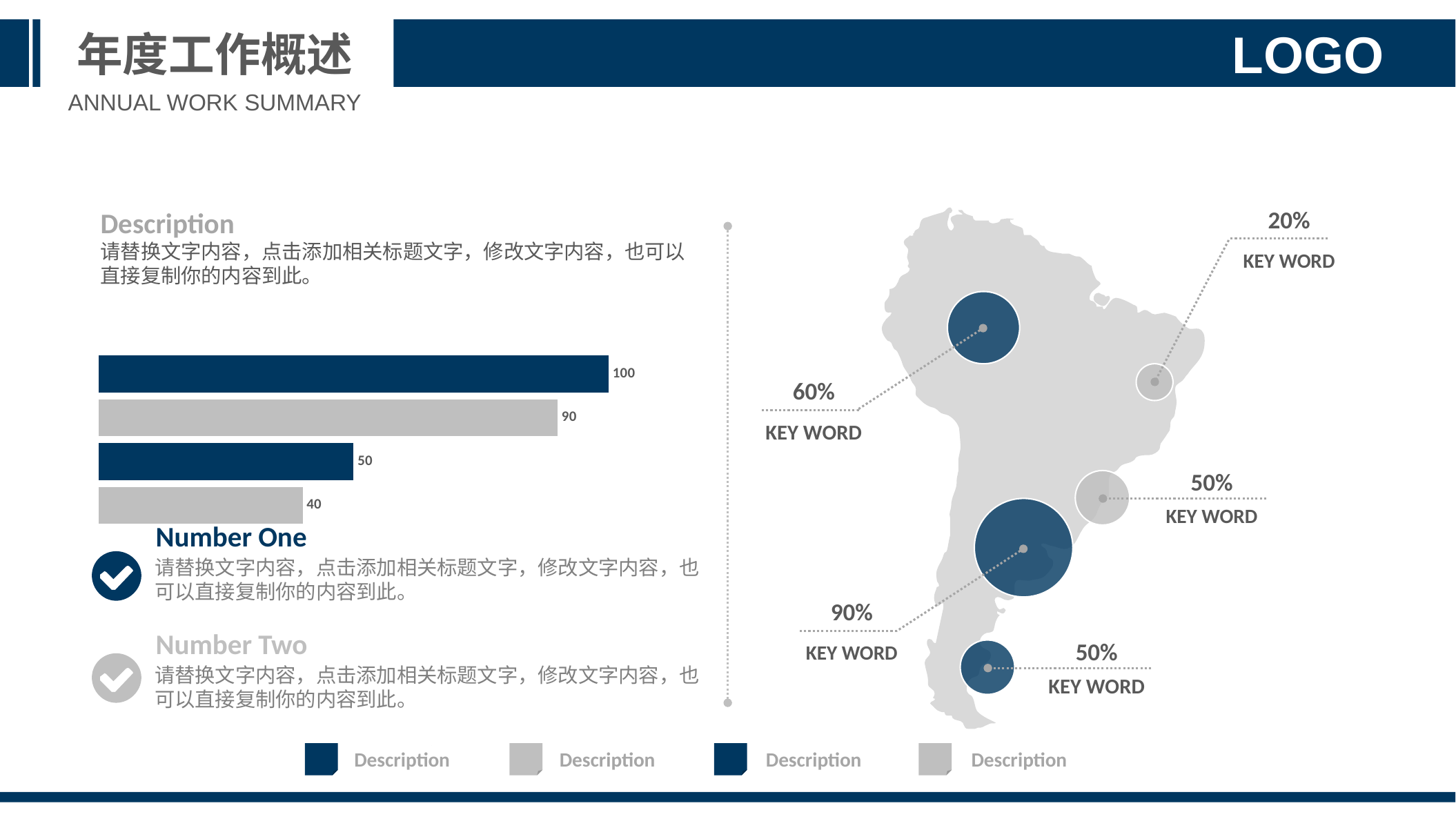
What is the value of the bottom bar in the bar chart? 40 Which bar in the bar chart has the lowest value? the bottom bar (40) What colour is the top bar in the bar chart? dark blue What is the value of the third bar from the top in the bar chart? 50 How many bars does the bar chart on the left contain? 4 What type of chart is shown on the left side of the slide? bar chart What is the difference between the top bar and the bottom bar in the bar chart? 60 What is the value of the top bar in the bar chart? 100 Do the bar values increase or decrease going from the top bar to the bottom bar? decrease Which bar in the bar chart has the highest value? the top bar (100) What is the value of the second bar from the top in the bar chart? 90 What is the difference between the second bar (90) and the third bar (50) in the bar chart? 40